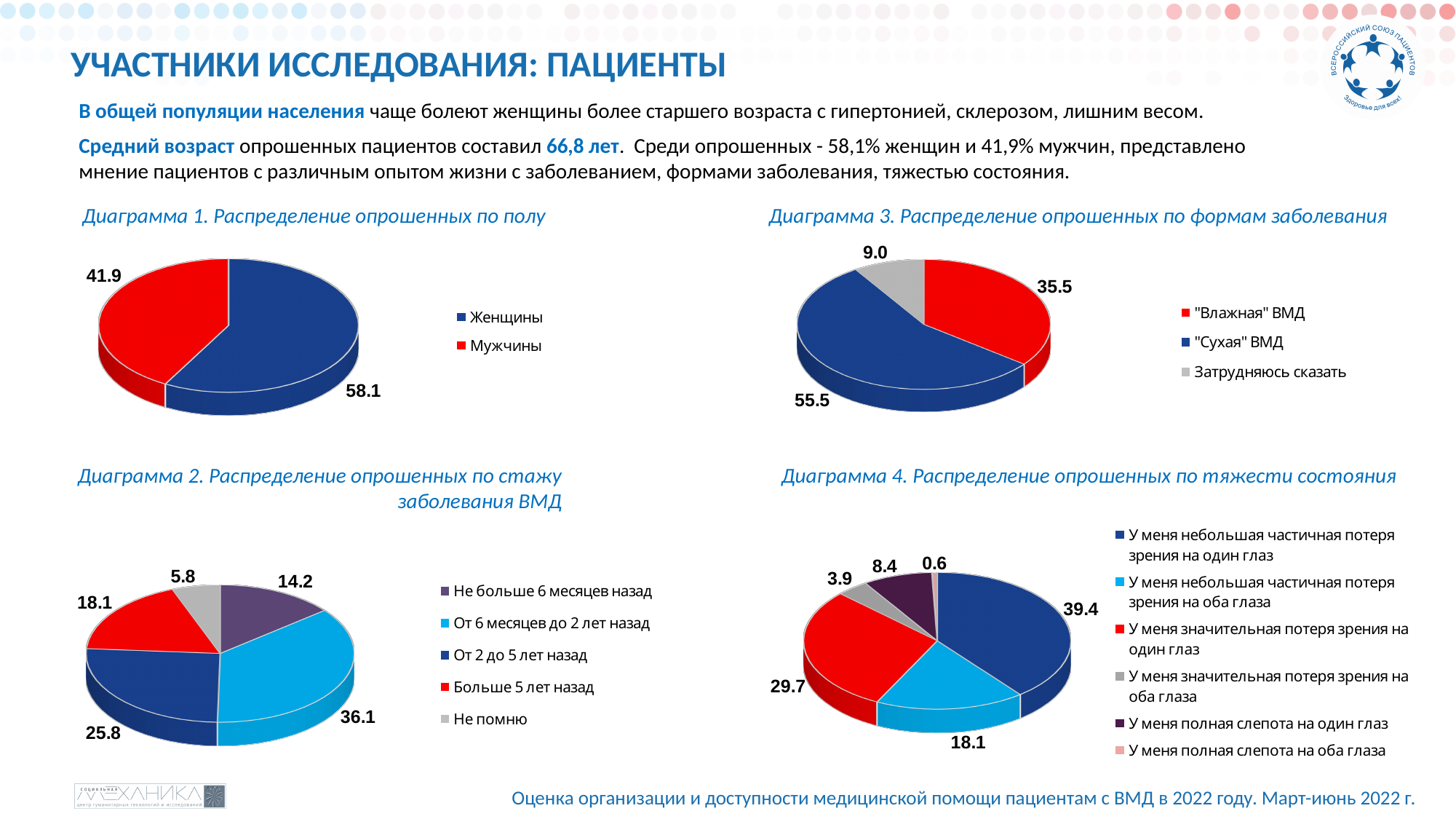
In Диаграмма 4 (Распределение опрошенных по тяжести состояния), which category has the smallest share? У меня полная слепота на оба глаза In Диаграмма 2 (Распределение опрошенных по стажу заболевания ВМД), which is larger: От 2 до 5 лет назад or Больше 5 лет назад? От 2 до 5 лет назад What type of chart is Диаграмма 1 (Распределение опрошенных по полу)? Pie chart In Диаграмма 1 (Распределение опрошенных по полу), what is the difference between the values for Женщины and Мужчины? 16.2 In Диаграмма 2 (Распределение опрошенных по стажу заболевания ВМД), which category has the smallest share? Не помню In Диаграмма 3 (Распределение опрошенных по формам заболевания), which category has the largest share? "Сухая" ВМД In Диаграмма 4 (Распределение опрошенных по тяжести состояния), what is the value for У меня значительная потеря зрения на один глаз? 29.7 In Диаграмма 2 (Распределение опрошенных по стажу заболевания ВМД), what is the value for От 6 месяцев до 2 лет назад? 36.1 In Диаграмма 1 (Распределение опрошенных по полу), what is the value for Женщины? 58.1 In Диаграмма 4 (Распределение опрошенных по тяжести состояния), how many categories are shown? 6 In Диаграмма 3 (Распределение опрошенных по формам заболевания), how many categories does the legend list? 3 In Диаграмма 3 (Распределение опрошенных по формам заболевания), what is the value for Затрудняюсь сказать? 9.0